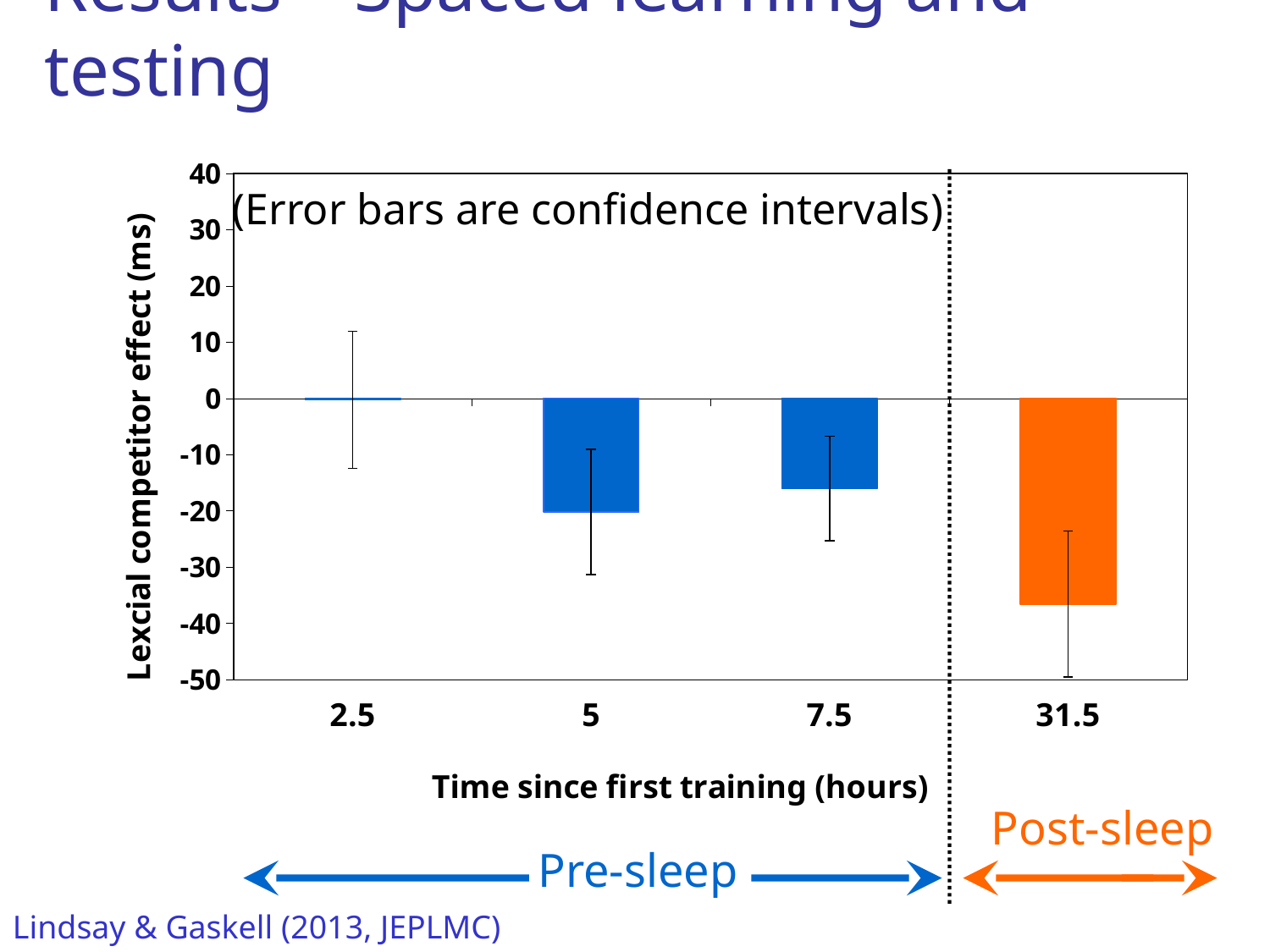
Which time point has the lowest (most negative) lexical competitor effect? 31.5 Which time point has the highest lexical competitor effect? 2.5 What colour is the bar for the post-sleep time point (31.5 hours)? orange Is the value for 31.5 hours greater or less than -30? less Which has the larger (less negative) lexical competitor effect, 5 hours or 31.5 hours? 5 How many time points (categories) are plotted on the x axis? 4 Which has the larger (less negative) lexical competitor effect, 5 hours or 7.5 hours? 7.5 Is the value for 7.5 hours greater or less than -20? greater What is the title of the x axis? Time since first training (hours) What kind of chart is shown on the slide? bar chart Is the value for 31.5 hours greater or less than -40? greater